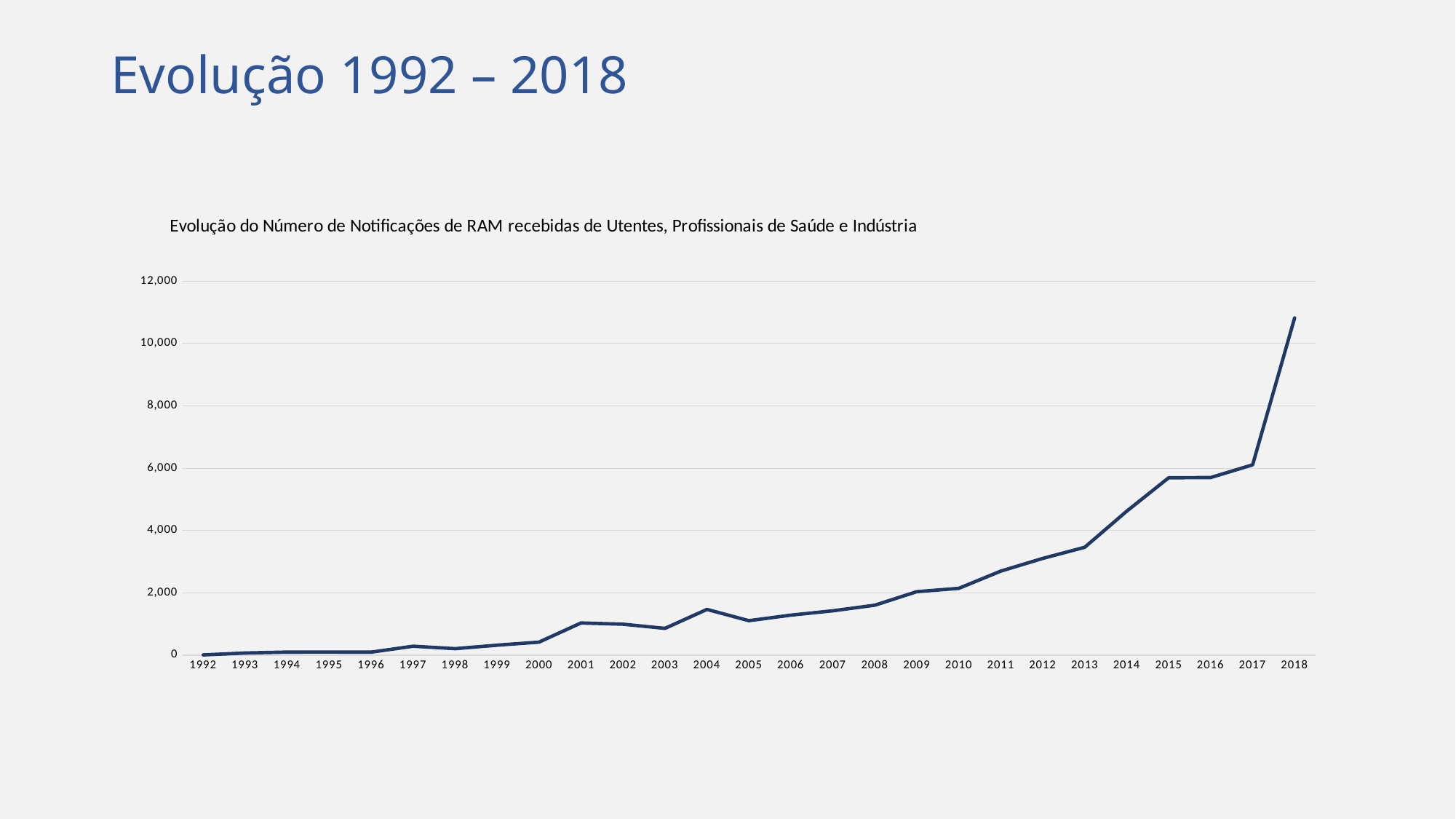
What kind of chart is shown on the slide? line chart Is the value for 2004 greater or less than 2,000? less Is the value for 2014 greater or less than 4,000? greater What is the title of the chart? Evolução do Número de Notificações de RAM recebidas de Utentes, Profissionais de Saúde e Indústria Is the value for 2011 greater or less than 2,000? greater Overall, do the values rise or fall from 1992 to 2018? rise Which year has the larger value, 2004 or 2005? 2004 How many years (data points) are plotted along the x axis? 27 Which year has the highest number of notifications? 2018